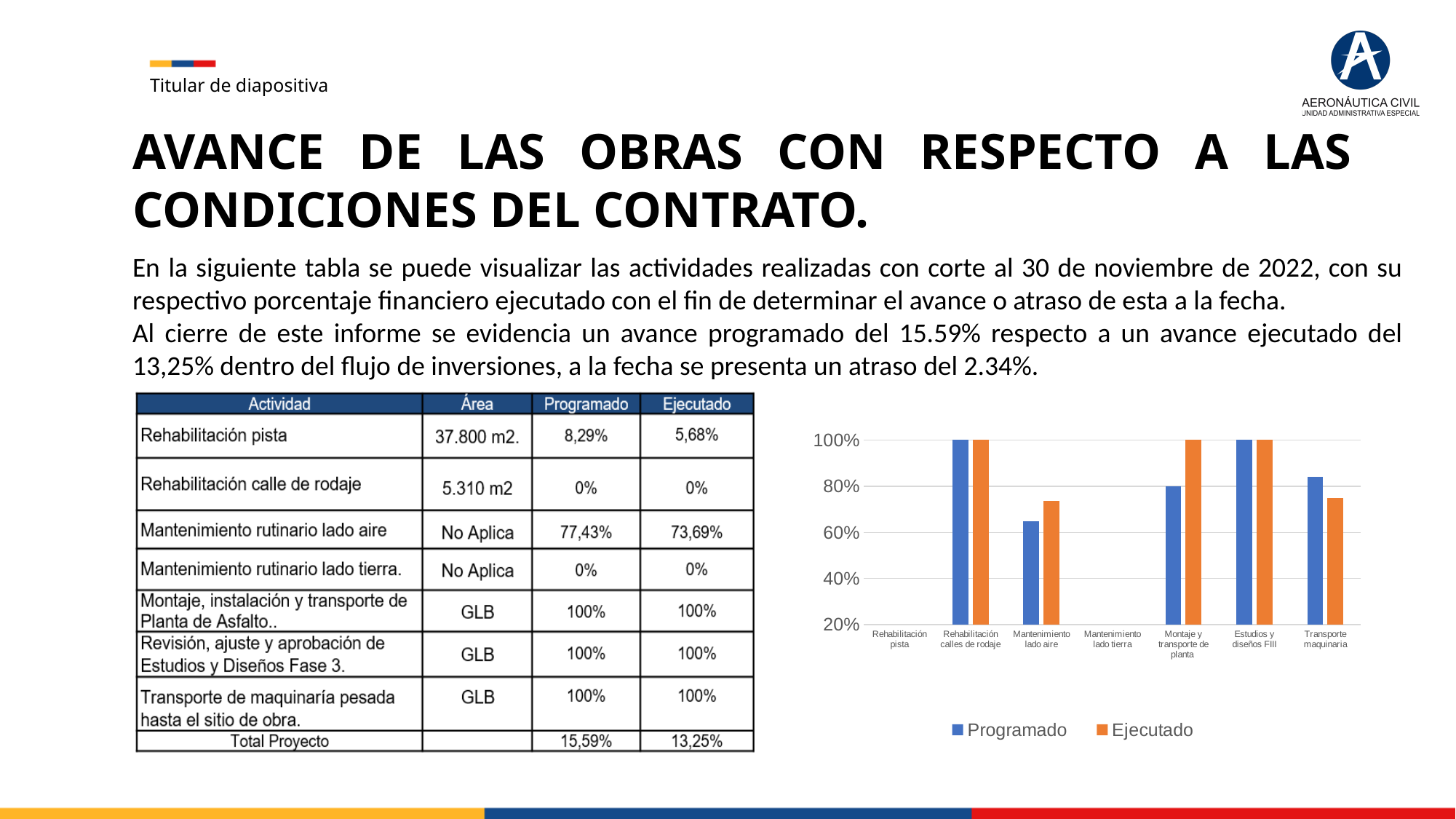
For Mantenimiento lado aire, which is larger: Programado or Ejecutado? Ejecutado What is the Programado value for Rehabilitación calles de rodaje in the chart? 100% Is the Ejecutado value for Mantenimiento lado aire greater or less than 60%? greater Is the Programado value for Mantenimiento lado aire greater or less than 80%? less What is the Ejecutado value for Estudios y diseños FIII in the chart? 100% How many series does the chart legend list? 2 What colour represents the Ejecutado series in the chart? orange For Montaje y transporte de planta, which is larger: Programado or Ejecutado? Ejecutado For Transporte maquinaria, which is larger: Programado or Ejecutado? Programado How many categories are shown along the x axis of the chart? 7 Is the Ejecutado value for Transporte maquinaria greater or less than 80%? less What kind of chart is shown on the right of the slide? bar chart